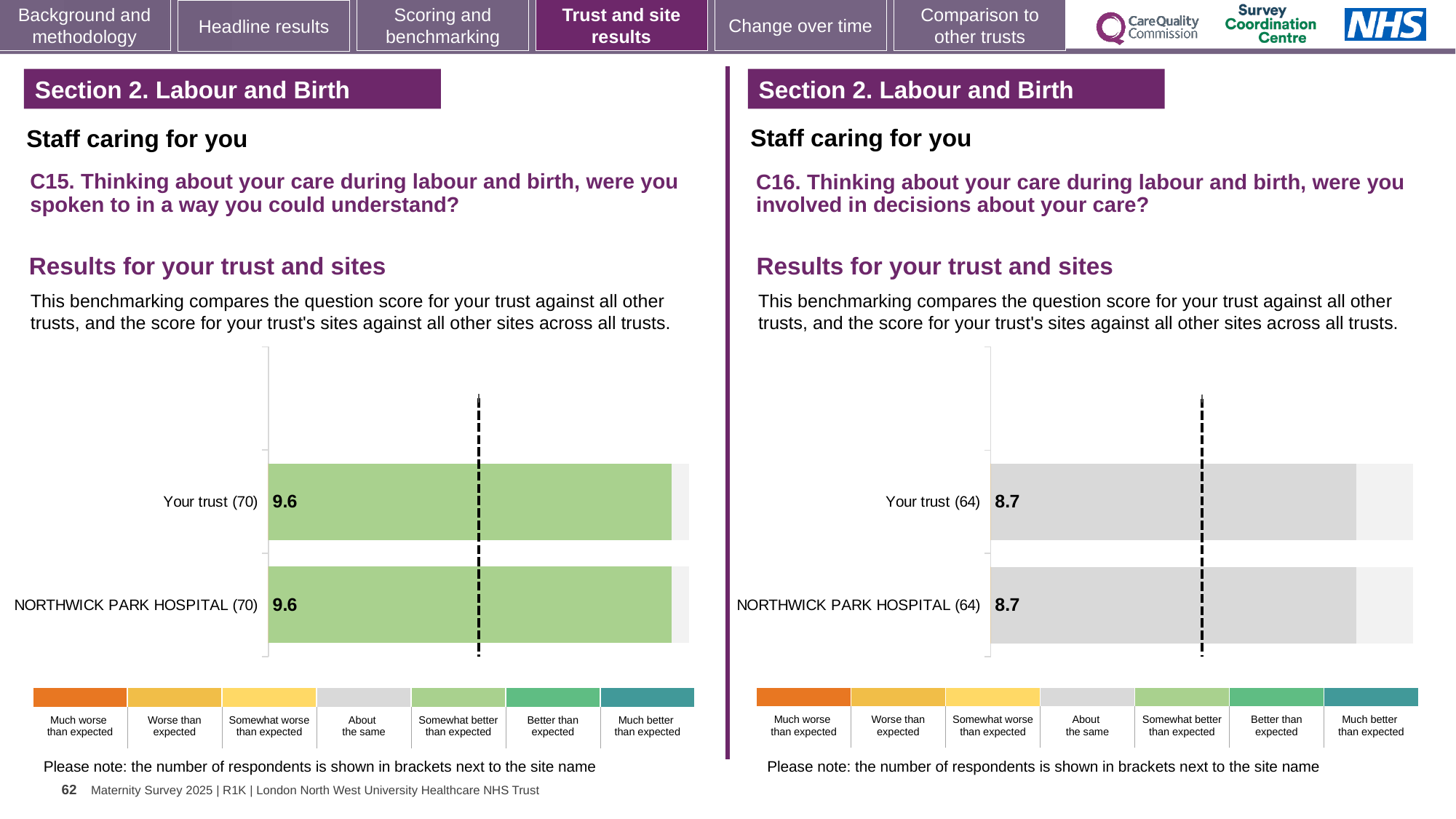
How many bars are plotted on the C15 chart (left)? 2 On the C15 chart (left), what is the score for NORTHWICK PARK HOSPITAL? 9.6 What kind of chart is used on the left side of the slide for question C15? Bar chart On the C16 chart (right), what is the score for NORTHWICK PARK HOSPITAL? 8.7 According to the colour key, which benchmark category do the grey bars on the C16 chart (right) represent? About the same On the C16 chart (right), what is the score for Your trust? 8.7 On the C15 chart (left), what is the difference between the score for Your trust and the score for NORTHWICK PARK HOSPITAL? 0 How many bars are plotted on the C16 chart (right)? 2 On the C15 chart (left), how many respondents are shown in brackets next to Your trust? 70 On the C16 chart (right), what is the difference between the score for Your trust and the score for NORTHWICK PARK HOSPITAL? 0 On the C15 chart (left), what is the score for Your trust? 9.6 On the C16 chart (right), how many respondents are shown in brackets next to NORTHWICK PARK HOSPITAL? 64